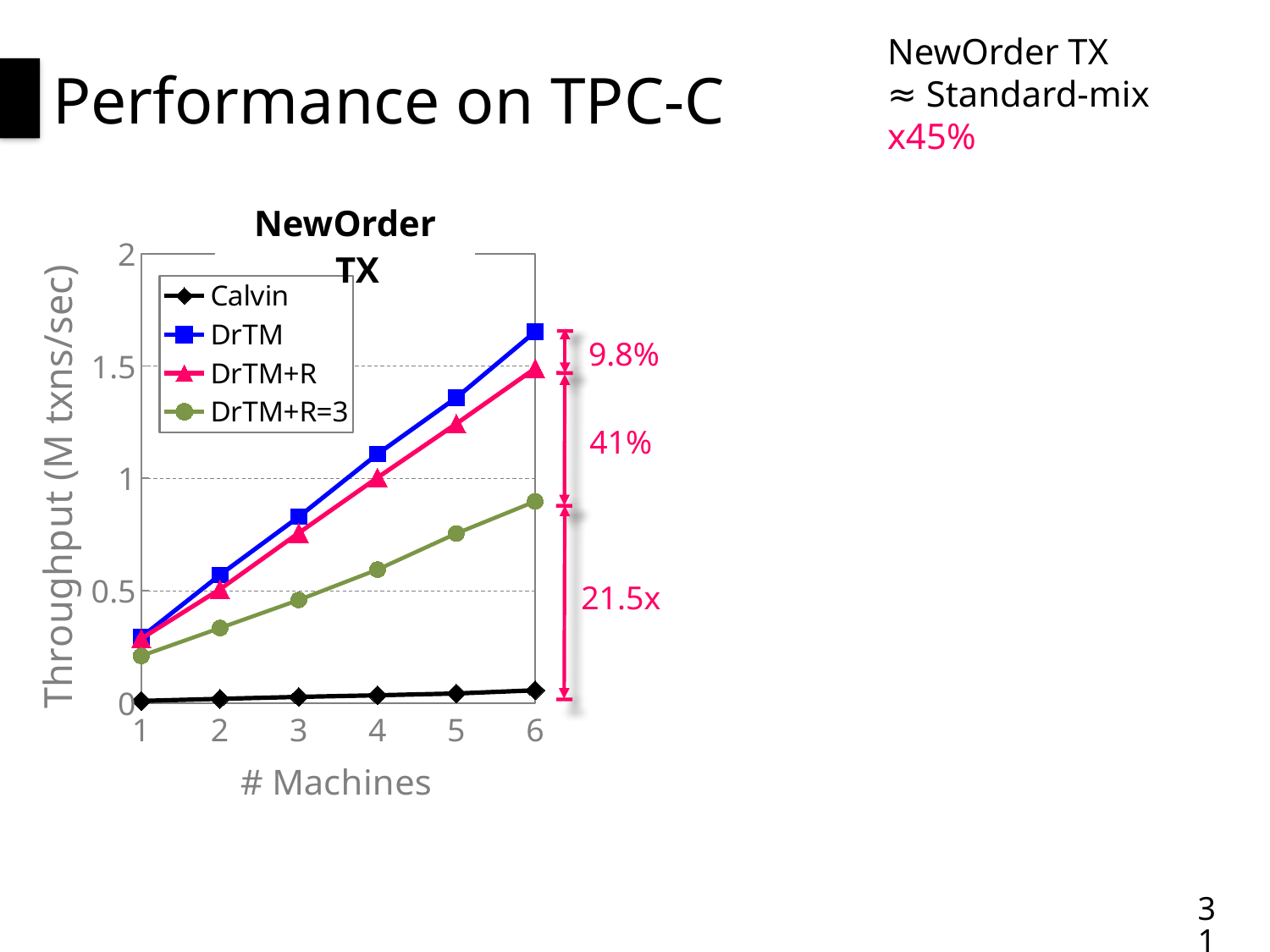
Is the throughput of DrTM at 4 machines greater or less than 1? greater Does the throughput of DrTM+R rise or fall as the number of machines increases? rise Is the throughput of Calvin at 6 machines greater or less than 0.5? less Is the throughput of DrTM at 6 machines greater or less than 1.5? greater Which series has the lowest throughput at 6 machines? Calvin What is the label of the y axis? Throughput (M txns/sec) At 6 machines, which has higher throughput: DrTM or DrTM+R=3? DrTM What kind of chart is shown on the slide? line chart Which series has the highest throughput at 6 machines? DrTM How many machine counts are plotted along the x axis? 6 How many series does the legend list? 4